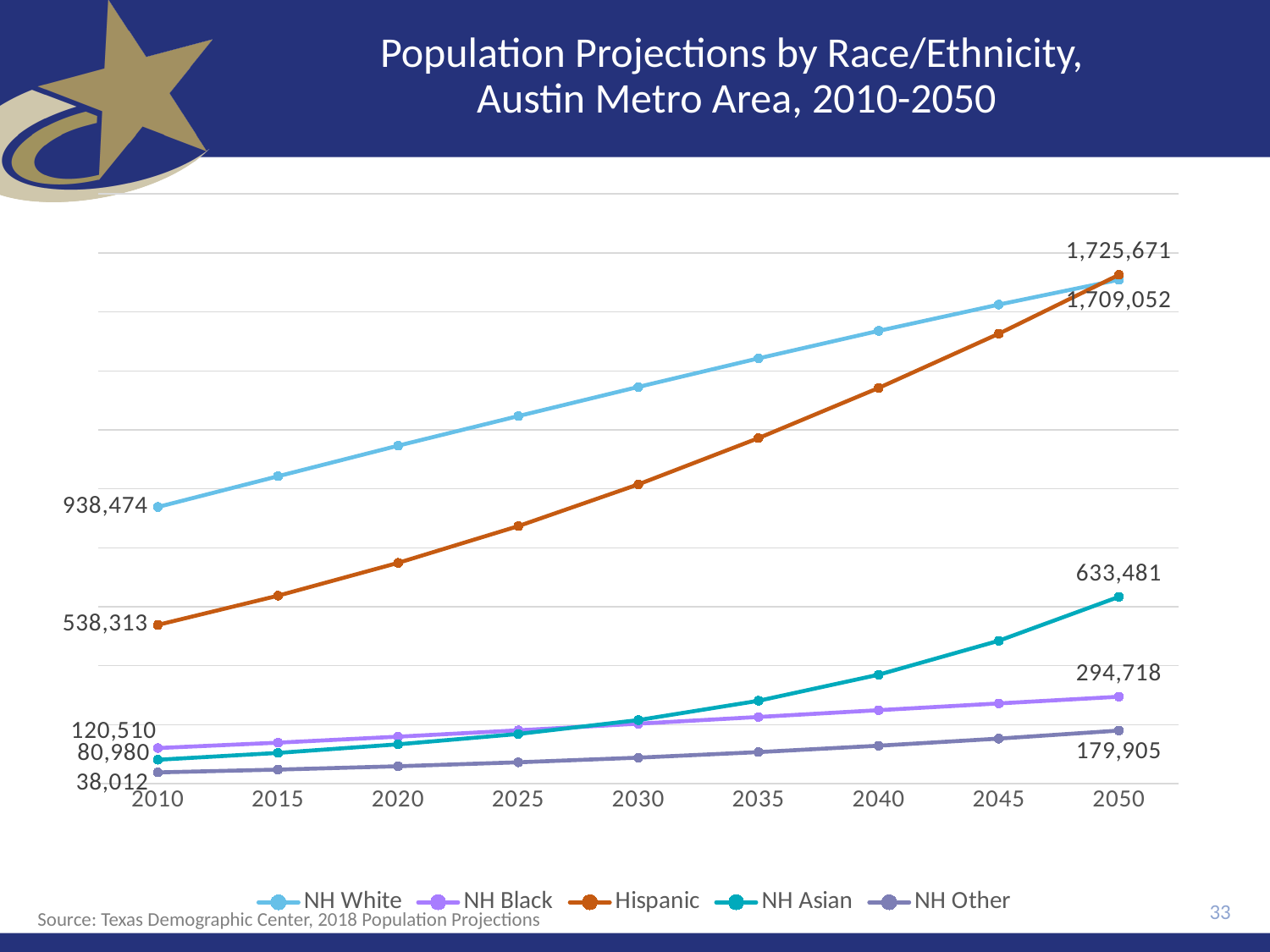
What is the projected NH White population in the Austin Metro Area in 2010? 938,474 How many series does the legend list? 5 Which race/ethnicity group has the largest projected population in 2050? Hispanic In 2010, which is larger: the NH Black population or the NH Asian population? NH Black Does the NH Asian population rise or fall from 2010 to 2050? Rise By how much is the NH Asian population projected to grow from 2010 to 2050? 552,501 How much larger is the projected Hispanic population than the NH White population in 2050? 16,619 What is the projected NH Asian population in 2050? 633,481 What kind of chart is shown on the slide? Line chart What is the projected NH Other population in 2010? 38,012 Which race/ethnicity group has the smallest projected population in 2010? NH Other What is the projected Hispanic population in the Austin Metro Area in 2050? 1,725,671